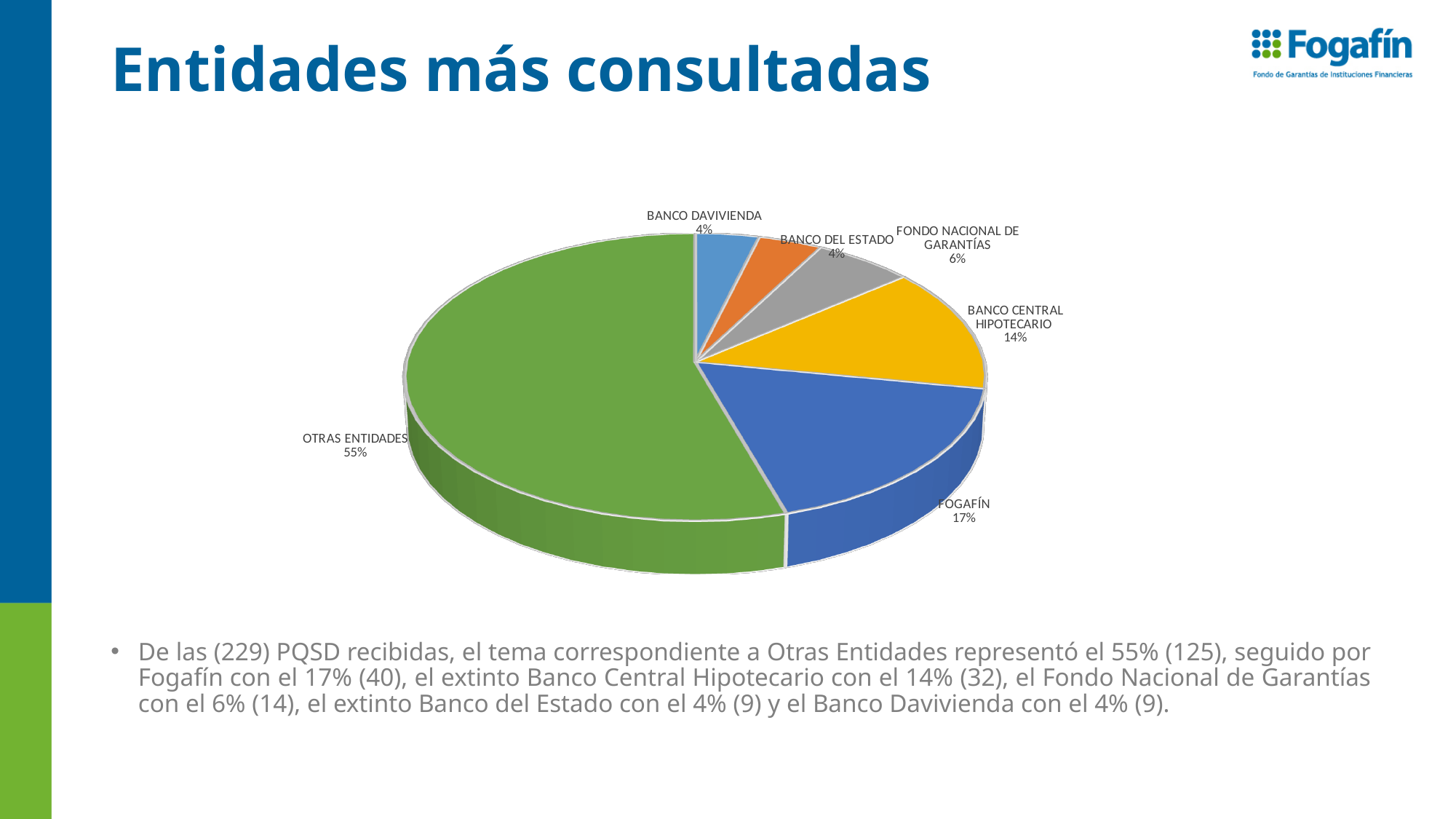
What share of the pie does BANCO CENTRAL HIPOTECARIO represent? 14% What is the difference in percentage points between the FOGAFÍN slice and the BANCO CENTRAL HIPOTECARIO slice? 3 What share of the pie does FOGAFÍN represent? 17% What is the difference in percentage points between the OTRAS ENTIDADES slice and the FOGAFÍN slice? 38 What share of the pie does BANCO DAVIVIENDA represent? 4% Which slice is larger, BANCO CENTRAL HIPOTECARIO or FONDO NACIONAL DE GARANTÍAS? BANCO CENTRAL HIPOTECARIO How many slices does the pie chart have? 6 What kind of chart is shown on the slide? Pie chart Which category has the largest slice of the pie? OTRAS ENTIDADES What colour is the OTRAS ENTIDADES slice? Green